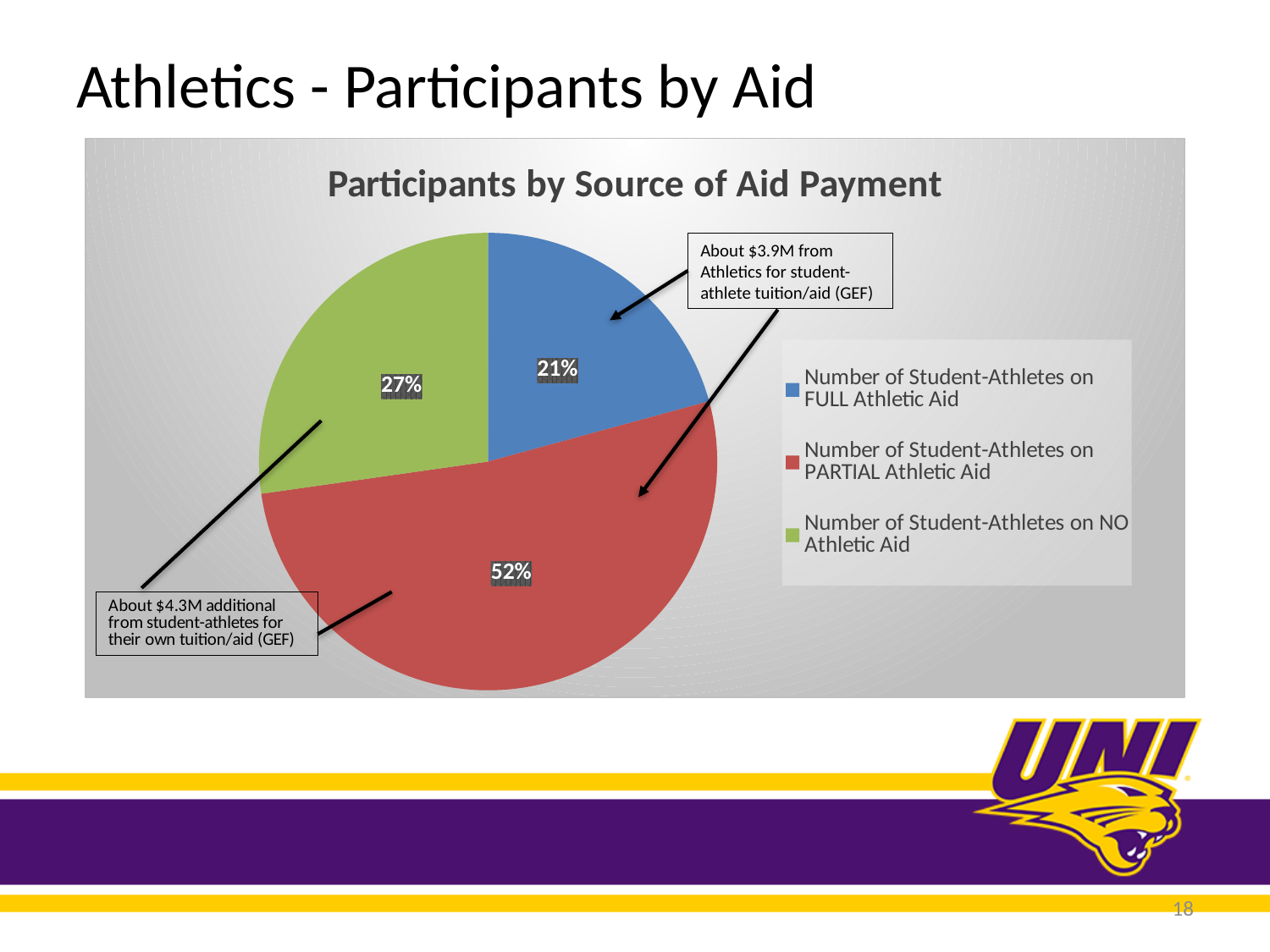
What share of the pie is Number of Student-Athletes on FULL Athletic Aid? 21% What is the difference in percentage points between the PARTIAL Athletic Aid slice and the FULL Athletic Aid slice? 31 What is the title of the chart? Participants by Source of Aid Payment What colour is the slice for Number of Student-Athletes on NO Athletic Aid? green Which category has the largest slice of the pie? Number of Student-Athletes on PARTIAL Athletic Aid Which category has the smallest slice of the pie? Number of Student-Athletes on FULL Athletic Aid What type of chart is shown on the slide? pie chart Which is larger: the NO Athletic Aid slice or the FULL Athletic Aid slice? NO Athletic Aid How many categories does the pie chart show? 3 What is the difference in percentage points between the NO Athletic Aid slice and the FULL Athletic Aid slice? 6 What share of the pie is Number of Student-Athletes on NO Athletic Aid? 27% What share of the pie is Number of Student-Athletes on PARTIAL Athletic Aid? 52%